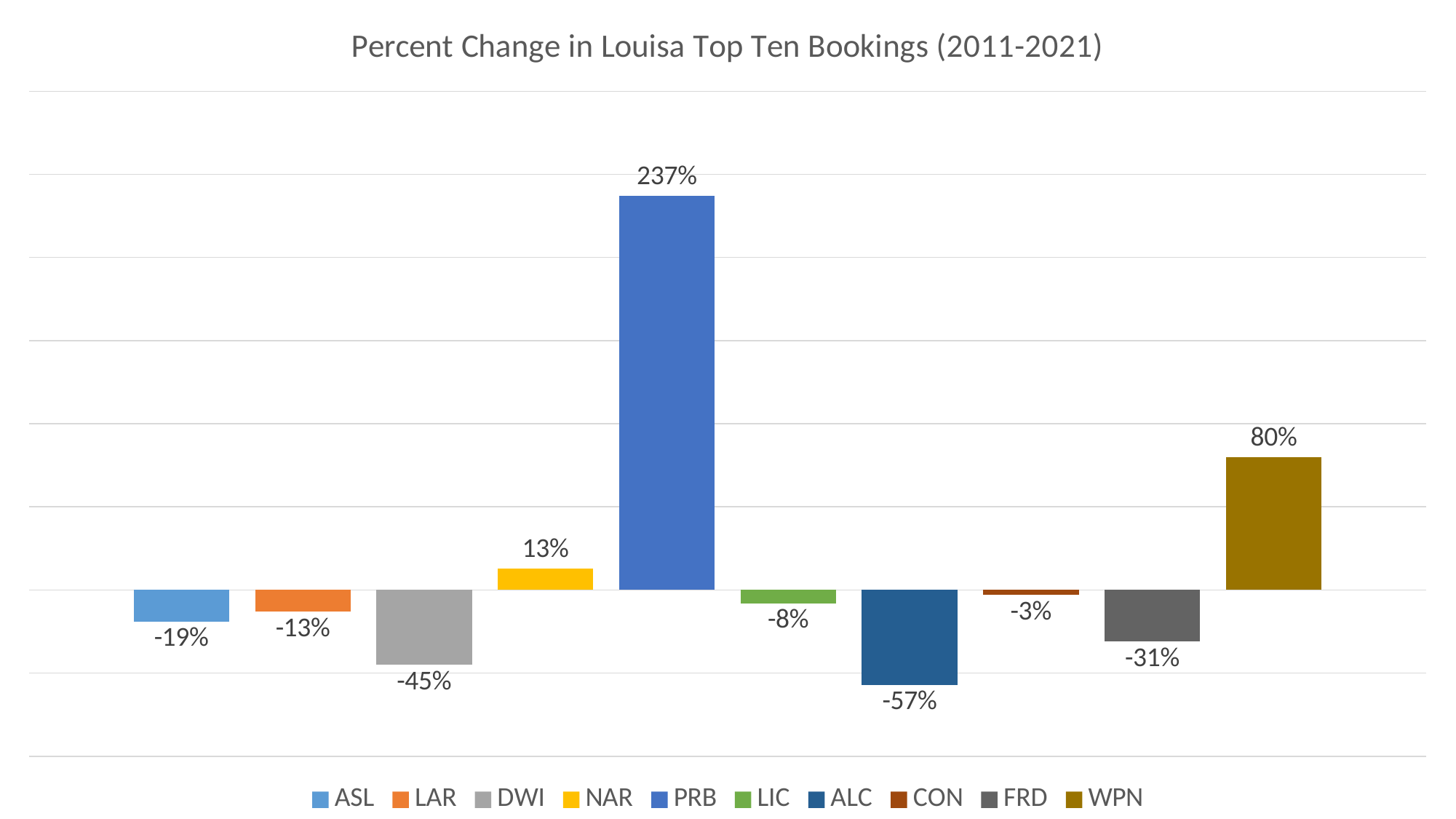
What is the percent change for CON? -3% What is the percent change for PRB? 237% What is the difference between the percent change for ASL and LAR? 6% What is the title of the chart? Percent Change in Louisa Top Ten Bookings (2011-2021) What is the percent change for DWI? -45% Which category has the highest percent change? PRB Which category has the lowest percent change? ALC How many categories are shown in the chart? 10 What kind of chart is this? Bar chart What is the percent change for WPN? 80% Which has a larger percent change, NAR or LIC? NAR What is the difference between the percent change for PRB and WPN? 157%